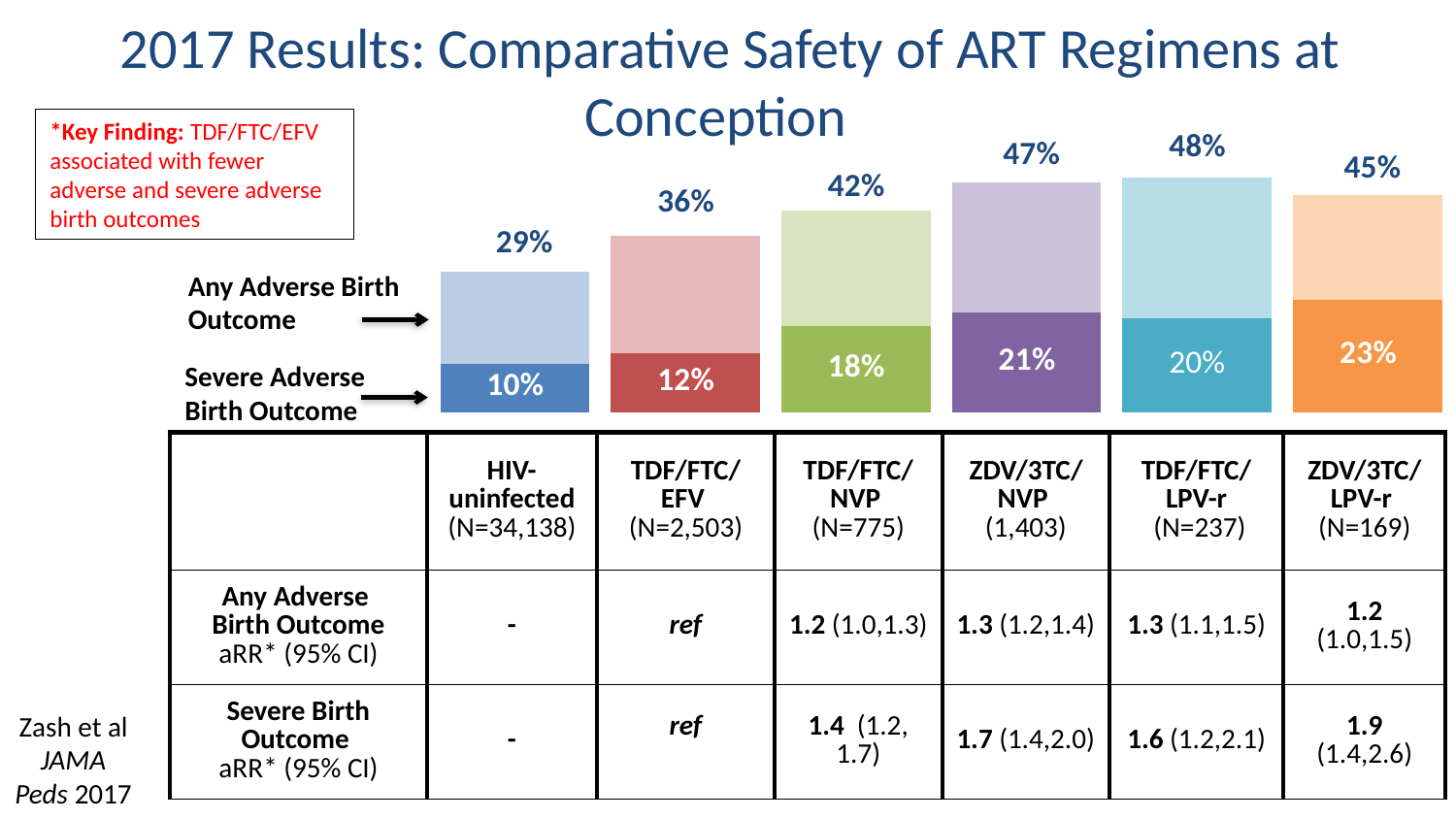
How many groups are shown in the bar chart? 6 What is the Severe Adverse Birth Outcome percentage for TDF/FTC/EFV? 12% Which group has the highest Severe Adverse Birth Outcome percentage? ZDV/3TC/LPV-r Which regimen group has the highest Any Adverse Birth Outcome percentage? TDF/FTC/LPV-r What is the Any Adverse Birth Outcome percentage for ZDV/3TC/NVP? 47% What type of chart is used to show the adverse birth outcome percentages? Bar chart What is the Any Adverse Birth Outcome percentage for the HIV-uninfected group? 29% What is the difference between the Any Adverse Birth Outcome percentage and the Severe Adverse Birth Outcome percentage for the HIV-uninfected group? 19 percentage points Which group has the lowest Severe Adverse Birth Outcome percentage? HIV-uninfected What is the Severe Adverse Birth Outcome percentage for ZDV/3TC/LPV-r? 23% Which has a higher Any Adverse Birth Outcome percentage, TDF/FTC/NVP or ZDV/3TC/NVP? ZDV/3TC/NVP How much higher is the Any Adverse Birth Outcome percentage for TDF/FTC/EFV than for HIV-uninfected? 7 percentage points